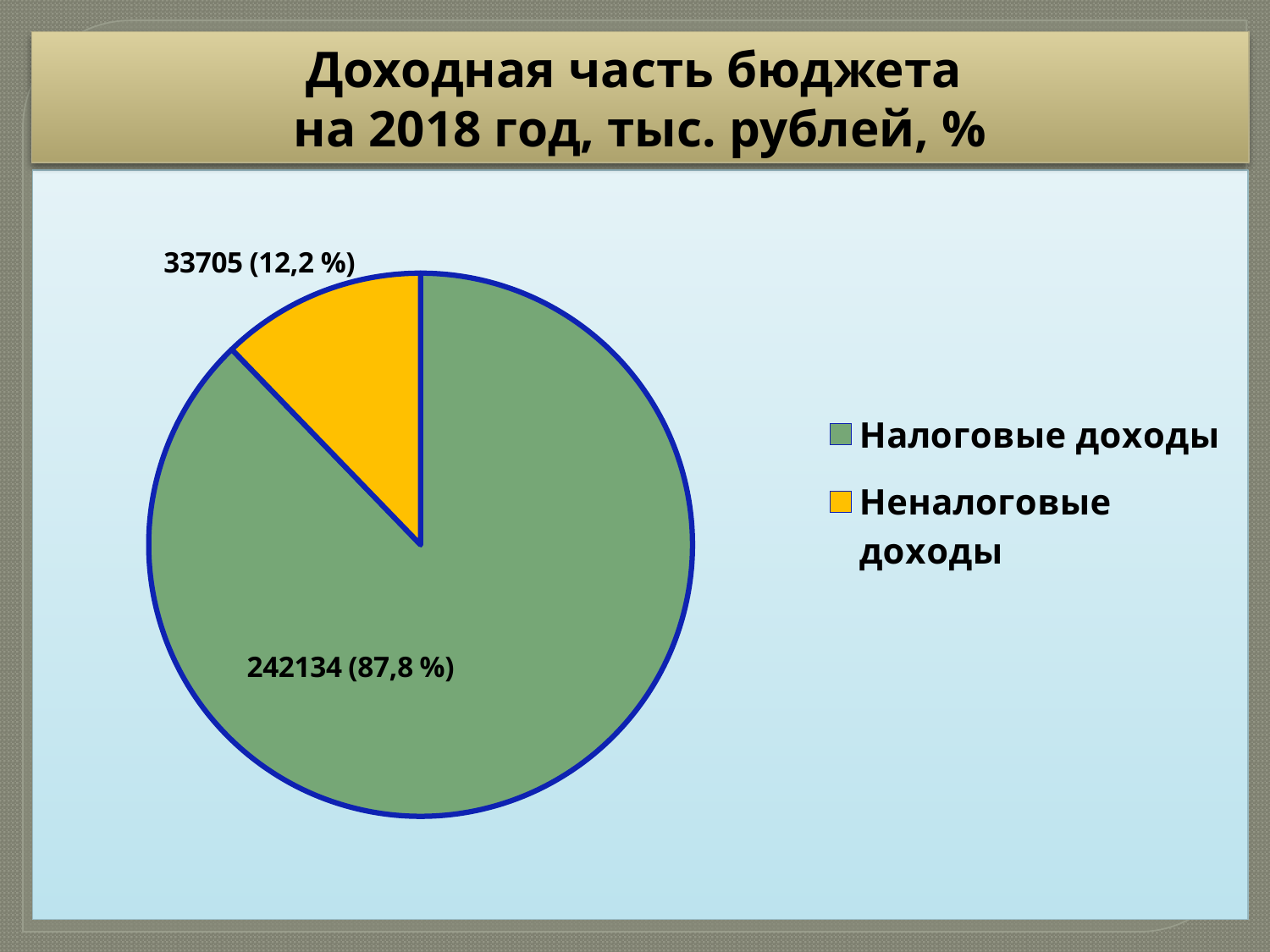
Which is larger, Налоговые доходы or Неналоговые доходы? Налоговые доходы Which category has the largest slice? Налоговые доходы What is the title of the chart? Доходная часть бюджета на 2018 год, тыс. рублей, % Which category has the smallest slice? Неналоговые доходы How many categories does the pie chart have? 2 What is the value for Налоговые доходы? 242134 What is the difference between the values for Налоговые доходы and Неналоговые доходы? 208429 What is the value for Неналоговые доходы? 33705 What colour is the slice for Неналоговые доходы? yellow What share of the pie does Налоговые доходы take? 87,8 % What kind of chart is shown on the slide? pie chart What share of the pie does Неналоговые доходы take? 12,2 %